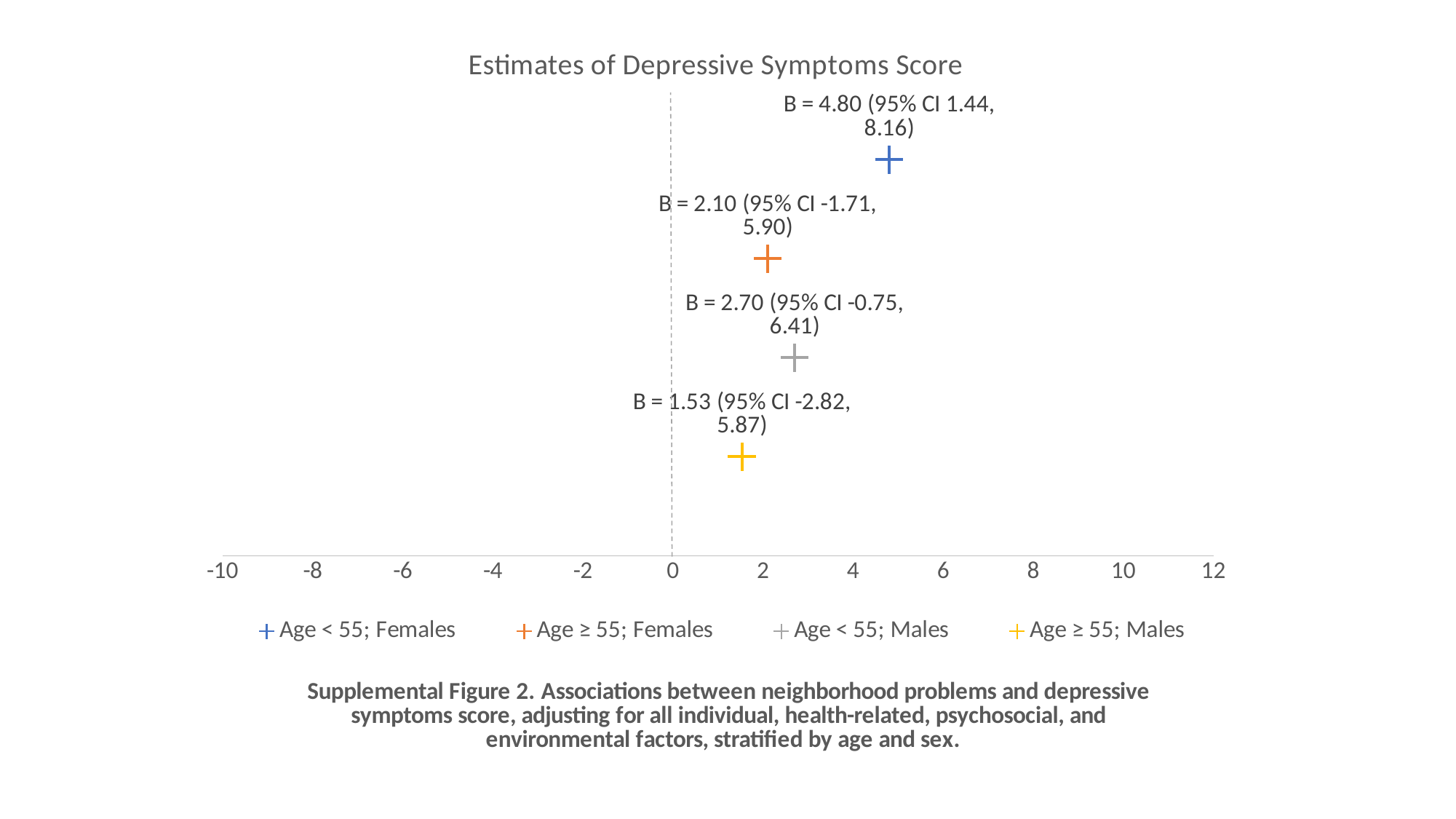
Is the B estimate for Age < 55; Females greater or less than 4? greater How many series does the legend list? 4 What is the title of the chart? Estimates of Depressive Symptoms Score What is the B estimate for Age < 55; Males? 2.70 Which group has the highest B estimate? Age < 55; Females What is the upper 95% confidence limit for Age < 55; Females? 8.16 What is the B estimate for Age ≥ 55; Females? 2.10 What is the B estimate for Age ≥ 55; Males? 1.53 What is the B estimate for Age < 55; Females? 4.80 Which has a larger B estimate, Age < 55; Males or Age ≥ 55; Females? Age < 55; Males Which group has the lowest B estimate? Age ≥ 55; Males What is the difference between the B estimates for Age < 55; Females and Age ≥ 55; Males? 3.27